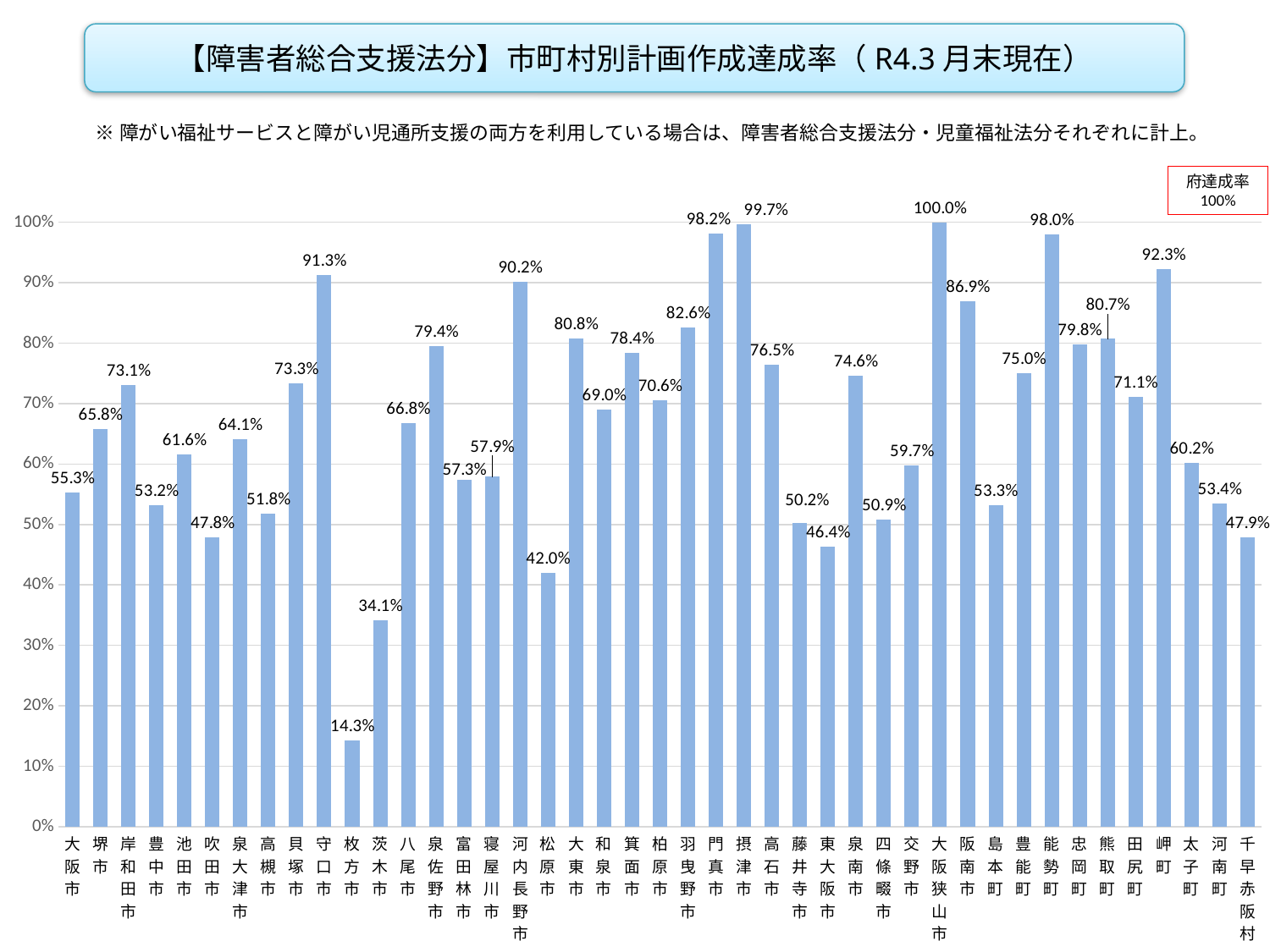
What is the 府達成率 shown in the box at the top right of the chart? 100% What is the value for 守口市? 91.3% What kind of chart is this? bar chart What is the difference between the values for 守口市 and 枚方市? 77.0 percentage points Which has a larger value, 大阪市 or 堺市? 堺市 How many municipalities are shown on the x axis? 43 What is the value for 千早赤阪村? 47.9% What is the difference between the values for 摂津市 and 門真市? 1.5 percentage points Which municipality has the lowest value? 枚方市 Which municipality has the highest value? 大阪狭山市 What is the value for 東大阪市? 46.4% Is the value for 茨木市 greater or less than 40%? less